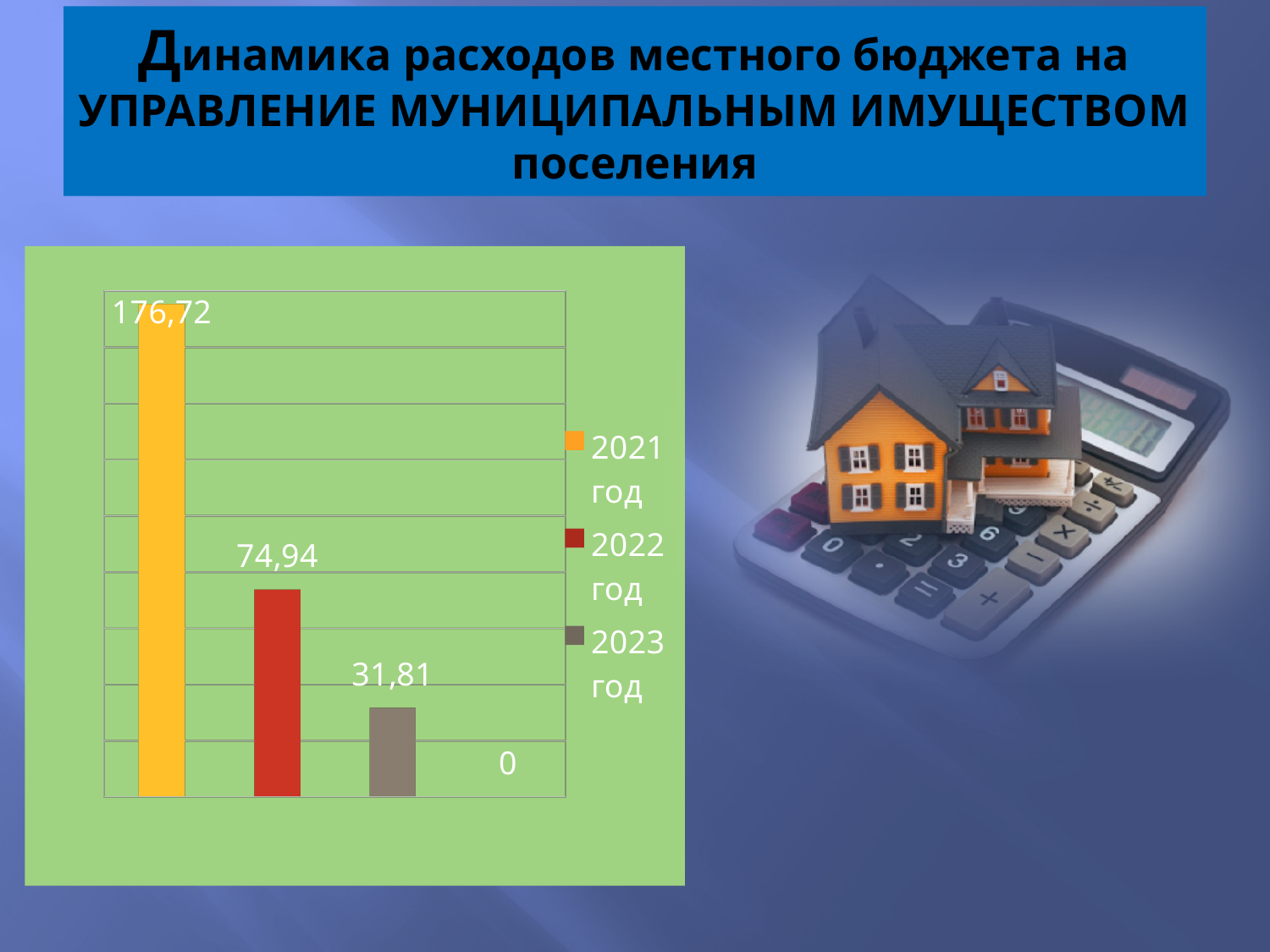
What is the difference between the values for 2021 год and 2022 год? 101,78 Do the values rise or fall from 2021 год to 2023 год? Fall What is the value for 2022 год? 74,94 What is the difference between the values for 2022 год and 2023 год? 43,13 What colour is the bar for 2021 год? Yellow Which year has the highest value? 2021 год Which is larger, the value for 2022 год or the value for 2023 год? 2022 год Which of the three years shown in the legend has the lowest value? 2023 год What is the value for 2023 год? 31,81 How many series does the legend list? 3 What is the value for 2021 год? 176,72 What kind of chart is shown on the slide? Bar chart